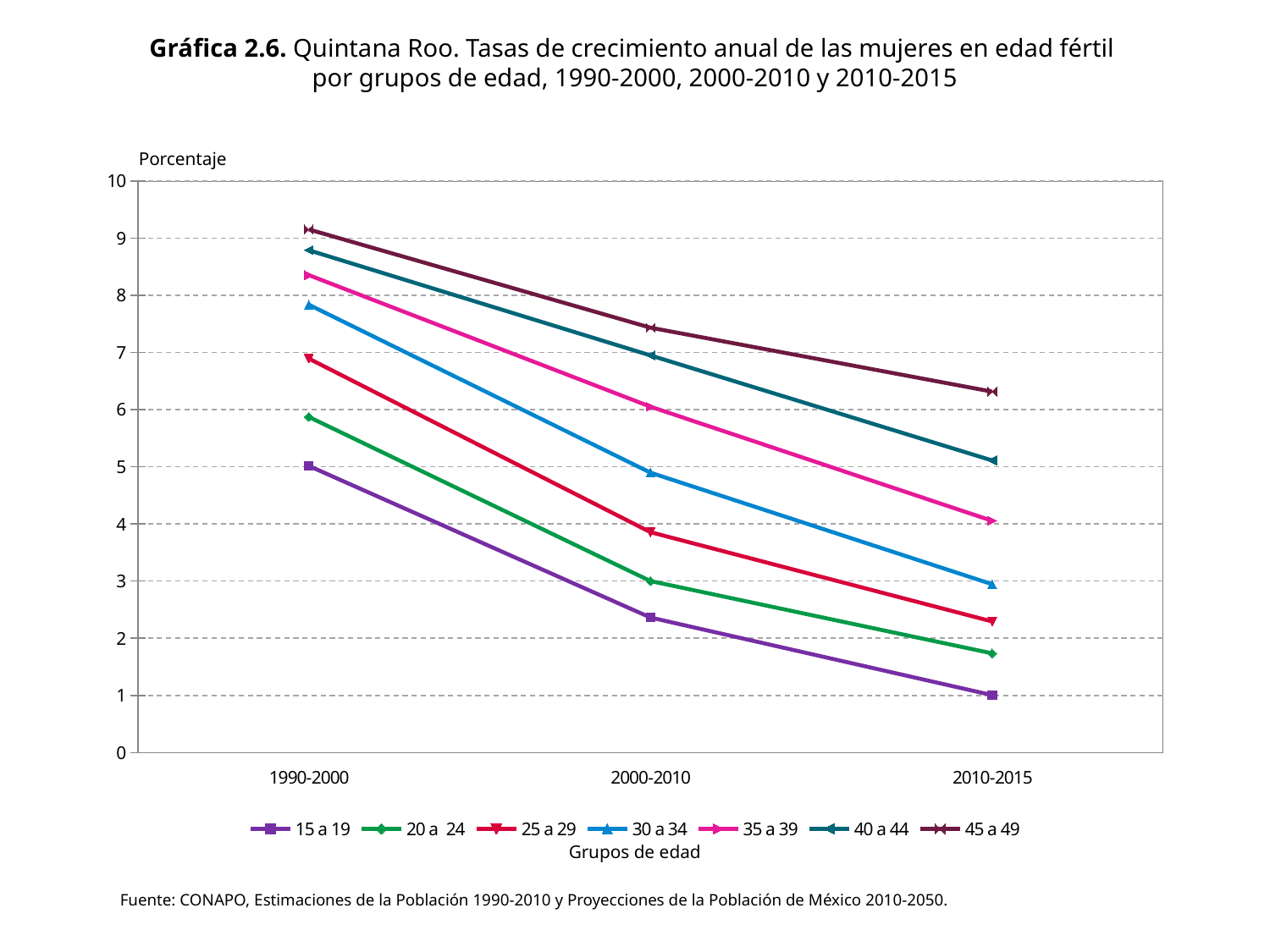
What is the label of the y axis? Porcentaje Does the growth rate for the 15 a 19 group rise or fall from 1990-2000 to 2010-2015? fall Is the value for 45 a 49 in 2010-2015 greater or less than 6? greater How many series does the legend list? 7 Which age group has the highest growth rate in 1990-2000? 45 a 49 Is the value for 45 a 49 in 1990-2000 greater or less than 8? greater Which age group has the lowest growth rate in 2010-2015? 15 a 19 How many periods are shown on the x axis? 3 Is the value for 25 a 29 in 2010-2015 greater or less than 2? greater Which is larger in 2000-2010, the value for 35 a 39 or the value for 30 a 34? 35 a 39 What kind of chart is shown on the slide? line chart